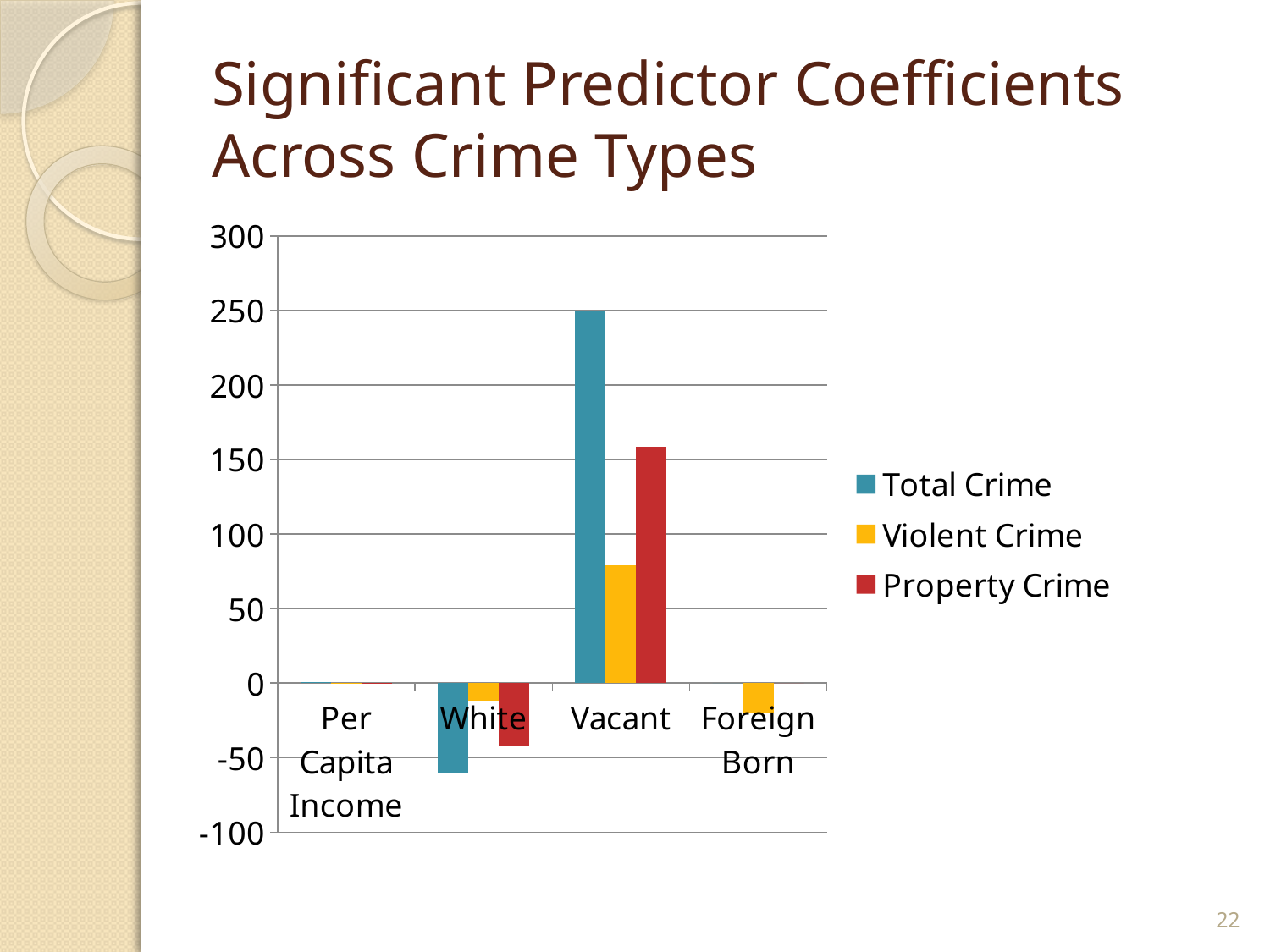
Is the Total Crime value for White greater or less than -50? less Is the Property Crime value for Vacant greater or less than 150? greater How many categories are shown on the x axis of the chart? 4 Which series is shown in red in the chart? Property Crime Which category has the highest Total Crime value? Vacant What is the title of the slide containing the chart? Significant Predictor Coefficients Across Crime Types Is the Violent Crime value for Vacant greater or less than 100? less How many series does the chart legend list? 3 Which category has the lowest Total Crime value? White For the Vacant category, which is larger: the Total Crime value or the Property Crime value? Total Crime What type of chart is shown on the slide? bar chart